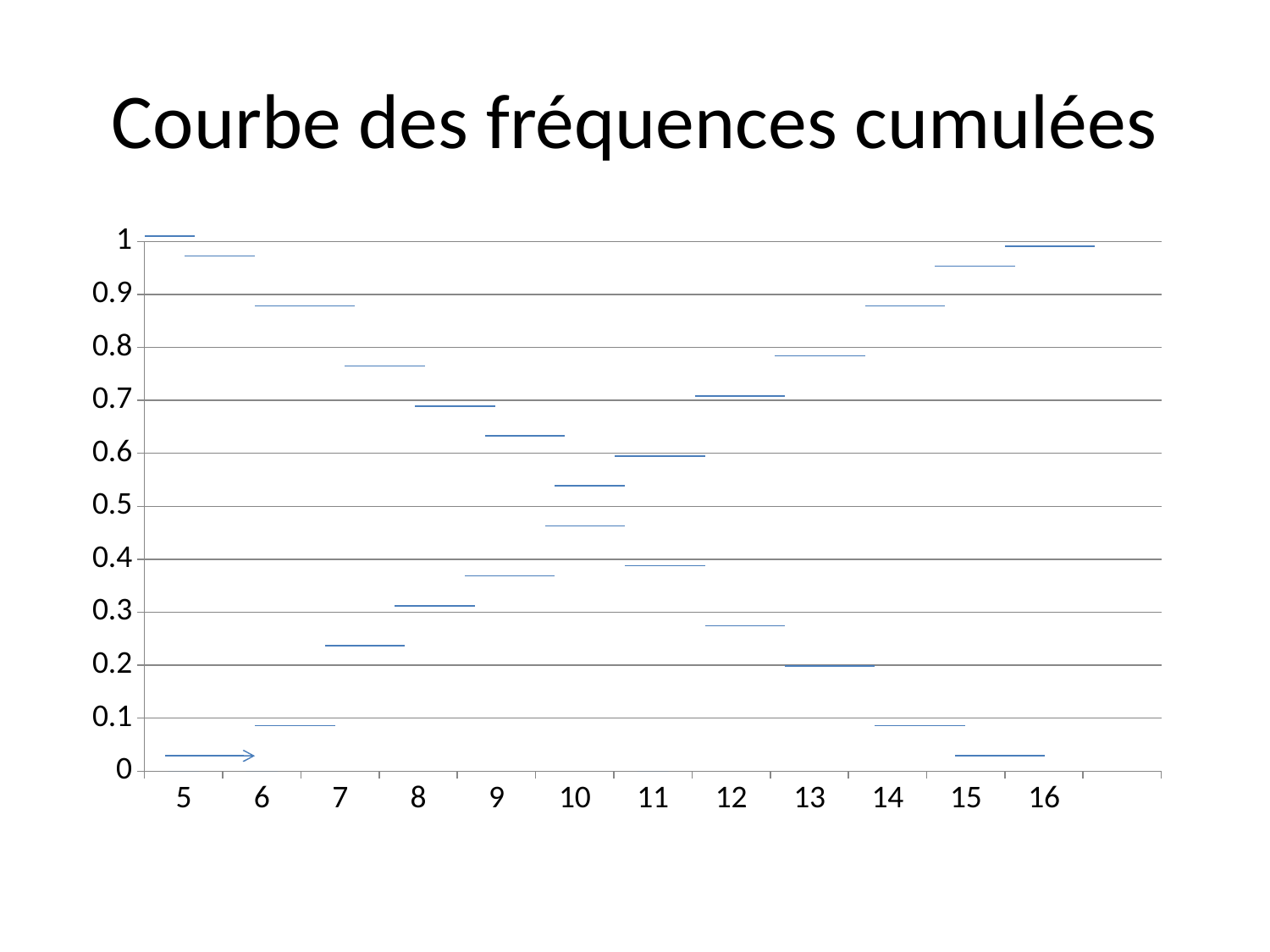
At x = 9, which series has the larger value, the rising step series or the falling step series? the falling step series How many x-axis categories are shown on the chart? 12 Does the step series that starts near 0 at x = 5 rise or fall as x increases? rise Is the value of the falling step series at x = 11 greater or less than 0.5? less What is the title of the chart? Courbe des fréquences cumulées Is the value of the rising step series at x = 14 greater or less than 0.8? greater Is the value of the falling step series at x = 13 greater or less than 0.3? less What is the highest value shown on the y axis of the chart? 1 Does the step series that starts at 1 at x = 5 rise or fall as x increases? fall